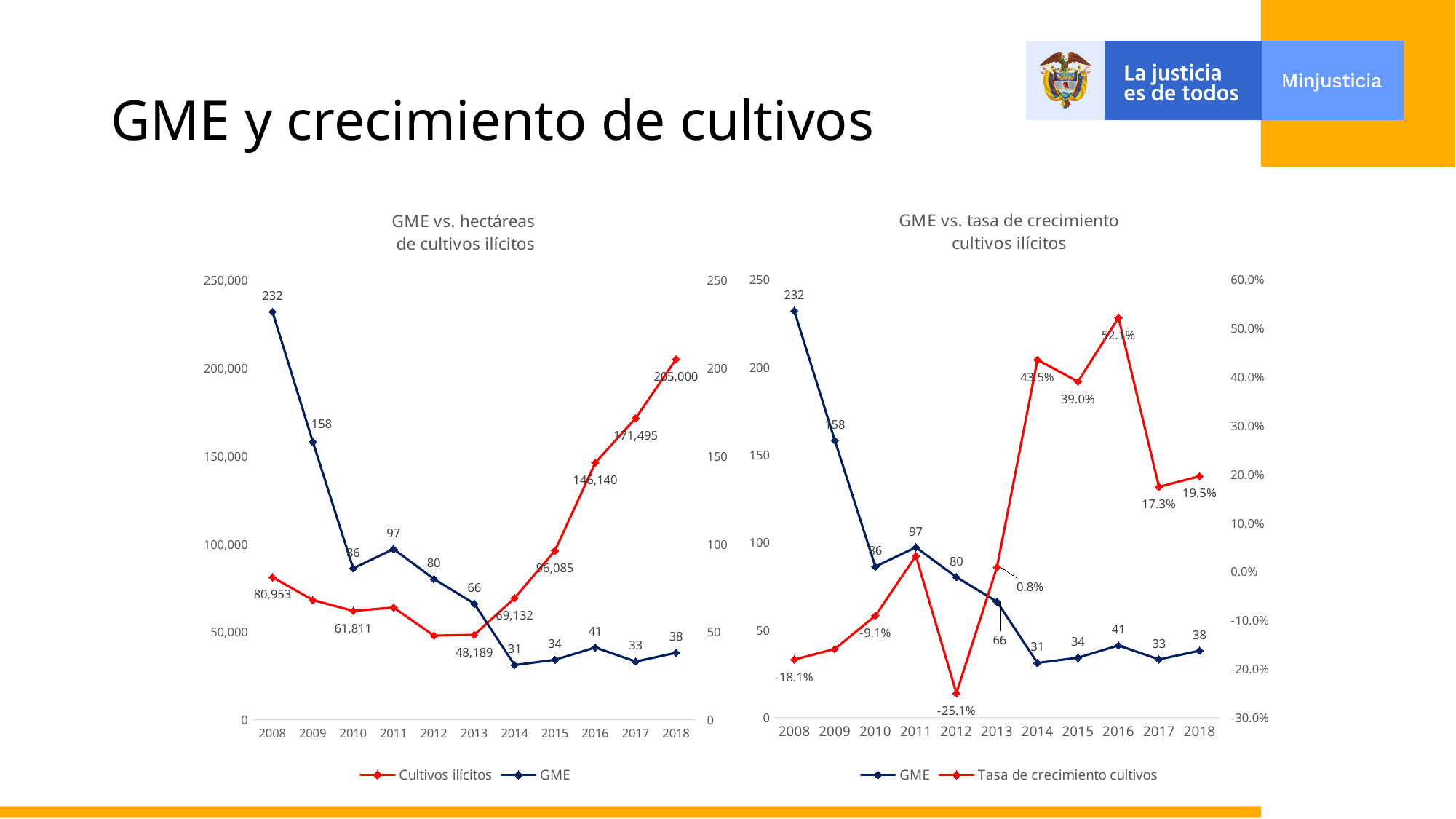
In the right chart (GME vs. tasa de crecimiento cultivos ilícitos), which year has the larger Tasa de crecimiento cultivos value, 2014 or 2015? 2014 In the left chart (GME vs. hectáreas de cultivos ilícitos), what is the Cultivos ilícitos value for 2018? 205,000 How many years are shown on the x axis of the left chart (GME vs. hectáreas de cultivos ilícitos)? 11 In the right chart (GME vs. tasa de crecimiento cultivos ilícitos), is the Tasa de crecimiento cultivos value for 2009 greater or less than 0.0%? less In the left chart (GME vs. hectáreas de cultivos ilícitos), is the Cultivos ilícitos value for 2011 greater or less than 100,000? less In the left chart (GME vs. hectáreas de cultivos ilícitos), what is the GME value for 2008? 232 In the right chart (GME vs. tasa de crecimiento cultivos ilícitos), which year has the lowest Tasa de crecimiento cultivos value? 2012 In the left chart (GME vs. hectáreas de cultivos ilícitos), which year has the lowest GME value? 2014 In the right chart (GME vs. tasa de crecimiento cultivos ilícitos), what is the Tasa de crecimiento cultivos value for 2012? -25.1% In the left chart (GME vs. hectáreas de cultivos ilícitos), what is the difference between the Cultivos ilícitos values for 2018 and 2017? 33,505 How many series does the legend of the right chart (GME vs. tasa de crecimiento cultivos ilícitos) list? 2 In the left chart (GME vs. hectáreas de cultivos ilícitos), which year has the larger Cultivos ilícitos value, 2008 or 2010? 2008